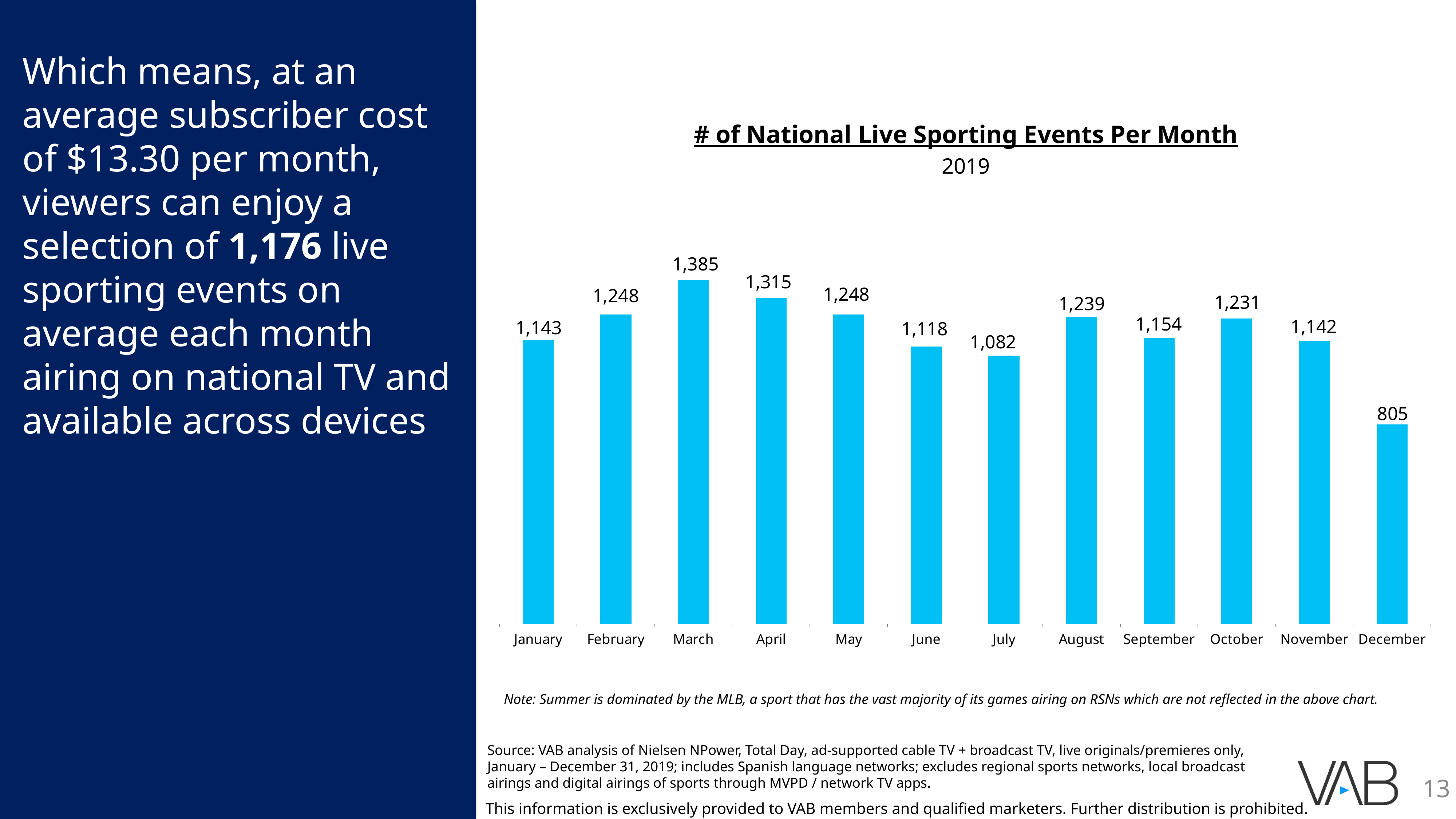
How many months are shown on the x axis of the chart? 12 What is the difference between the April and July values? 233 What year does the chart cover, according to its subtitle? 2019 Which is larger, the value for June or the value for July? June What is the value shown for September? 1,154 Which month has the highest number of national live sporting events? March Which month has the lowest number of national live sporting events? December What is the number of national live sporting events in December? 805 Which is larger, the value for August or the value for October? August What kind of chart is used to show the number of national live sporting events per month? Bar chart What is the number of national live sporting events in March? 1,385 What is the difference between the March and December values? 580